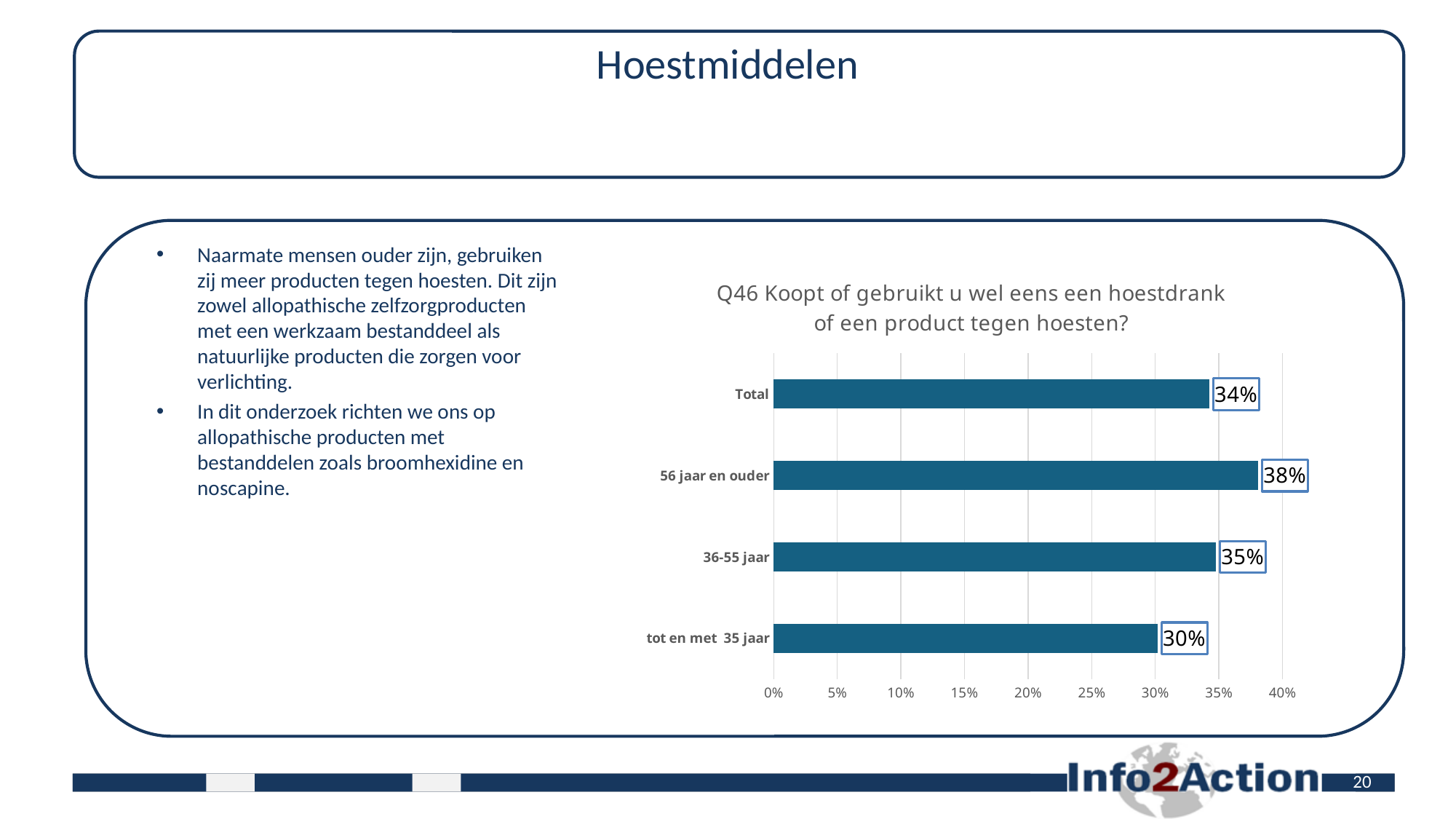
Which category has the lowest value? tot en met 35 jaar Is the value for 56 jaar en ouder greater or less than 35%? greater How many categories are shown in the chart? 4 What kind of chart is shown on the slide? bar chart What is the value for 36-55 jaar? 35% What is the title of the chart? Q46 Koopt of gebruikt u wel eens een hoestdrank of een product tegen hoesten? What is the value for Total? 34% What is the difference between the values for 56 jaar en ouder and tot en met 35 jaar? 8% Which category has the highest value? 56 jaar en ouder What is the value for 56 jaar en ouder? 38% What is the value for tot en met 35 jaar? 30% Which is larger, the value for 36-55 jaar or the value for tot en met 35 jaar? 36-55 jaar